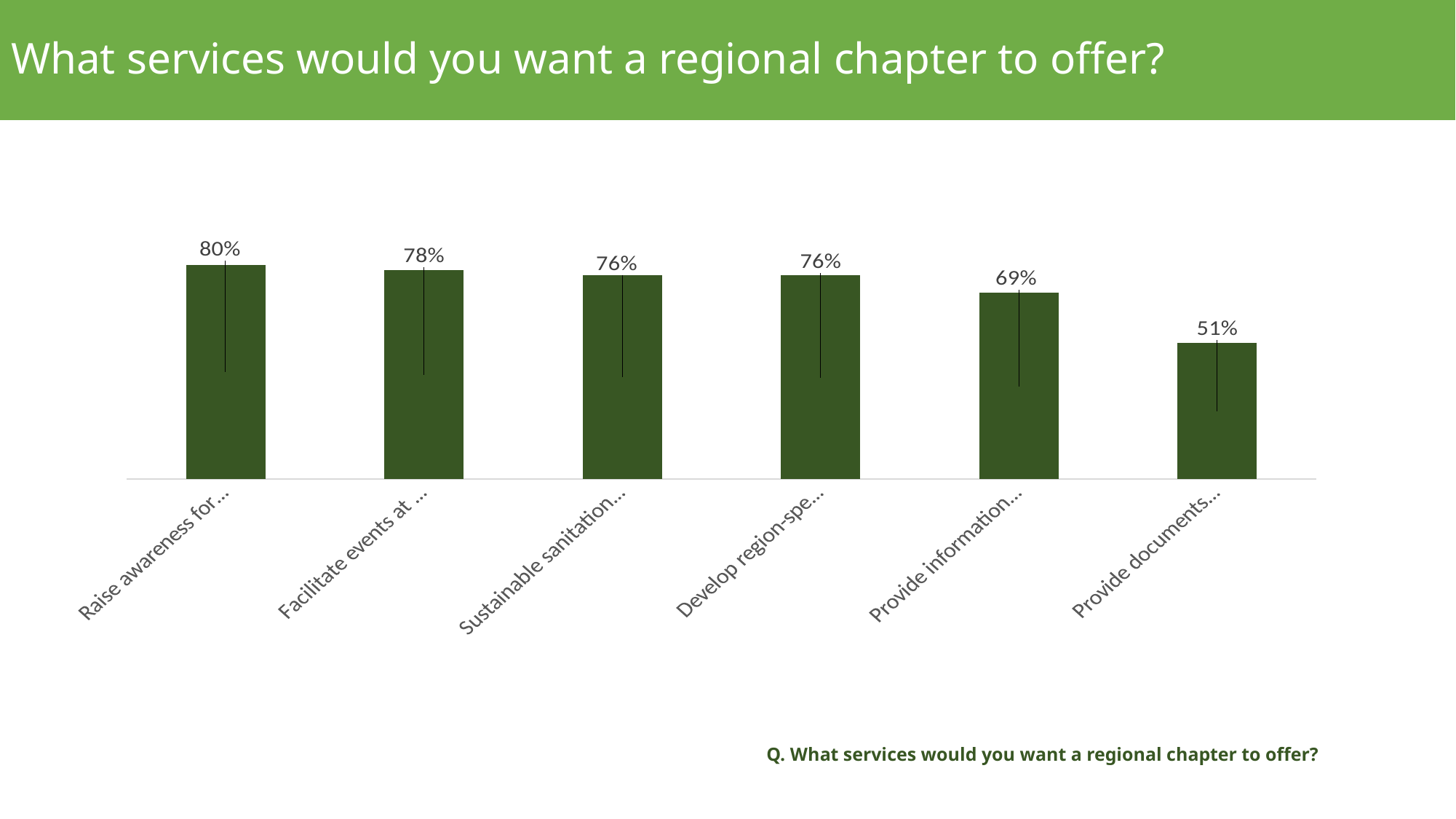
How many bars (categories) are shown in the chart? 6 What is the value for the category beginning "Provide information"? 69% Which is larger, the value for "Facilitate events at..." or the value for "Provide information..."? Facilitate events at... What type of chart is shown on the slide? bar chart What is the value for the category beginning "Facilitate events at"? 78% What is the title of the slide? What services would you want a regional chapter to offer? What is the difference between the values for "Raise awareness for..." and "Provide documents..."? 29% What is the value for the category beginning "Provide documents"? 51% What is the value for the category beginning "Raise awareness for"? 80% Do the values rise or fall from left to right across the chart? fall Which category has the lowest value? Provide documents... Which category has the highest value? Raise awareness for...